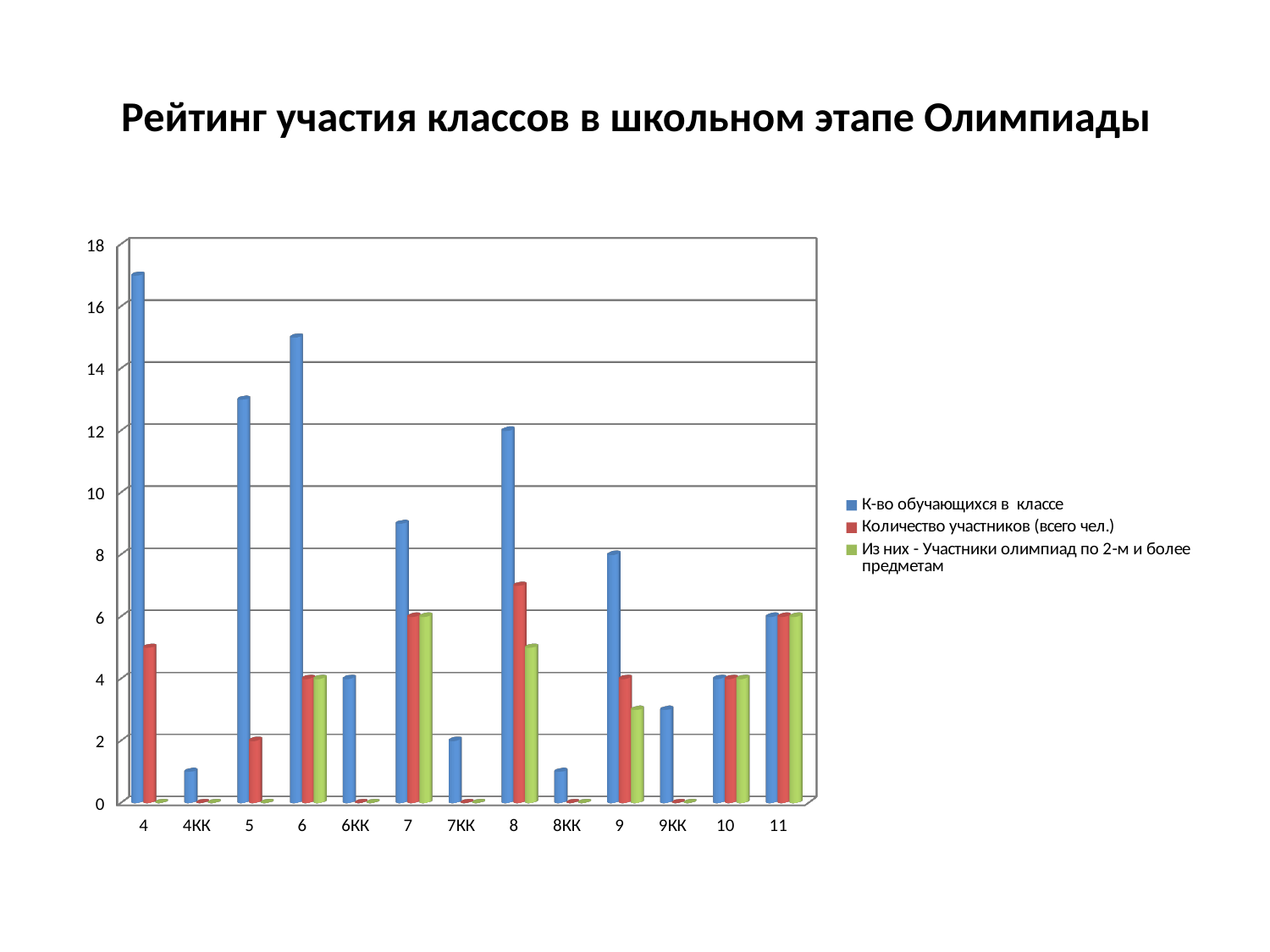
Is the value of 'Количество участников (всего чел.)' for class 8 greater or less than 6? greater Which class has the larger value for 'К-во обучающихся в классе', class 5 or class 6? 6 How many class categories are shown on the x axis? 13 What kind of chart is shown on the slide? bar chart What is the value of 'К-во обучающихся в классе' for class 11? 6 Which class has the highest value for 'К-во обучающихся в классе'? 4 What is the value of 'К-во обучающихся в классе' for class 6КК? 4 Is the value of 'К-во обучающихся в классе' for class 9КК greater or less than 4? less What is the value of 'Количество участников (всего чел.)' for class 10? 4 What is the title of the chart on the slide? Рейтинг участия классов в школьном этапе Олимпиады Is the value of 'К-во обучающихся в классе' for class 4 greater or less than 16? greater How many series does the legend list? 3